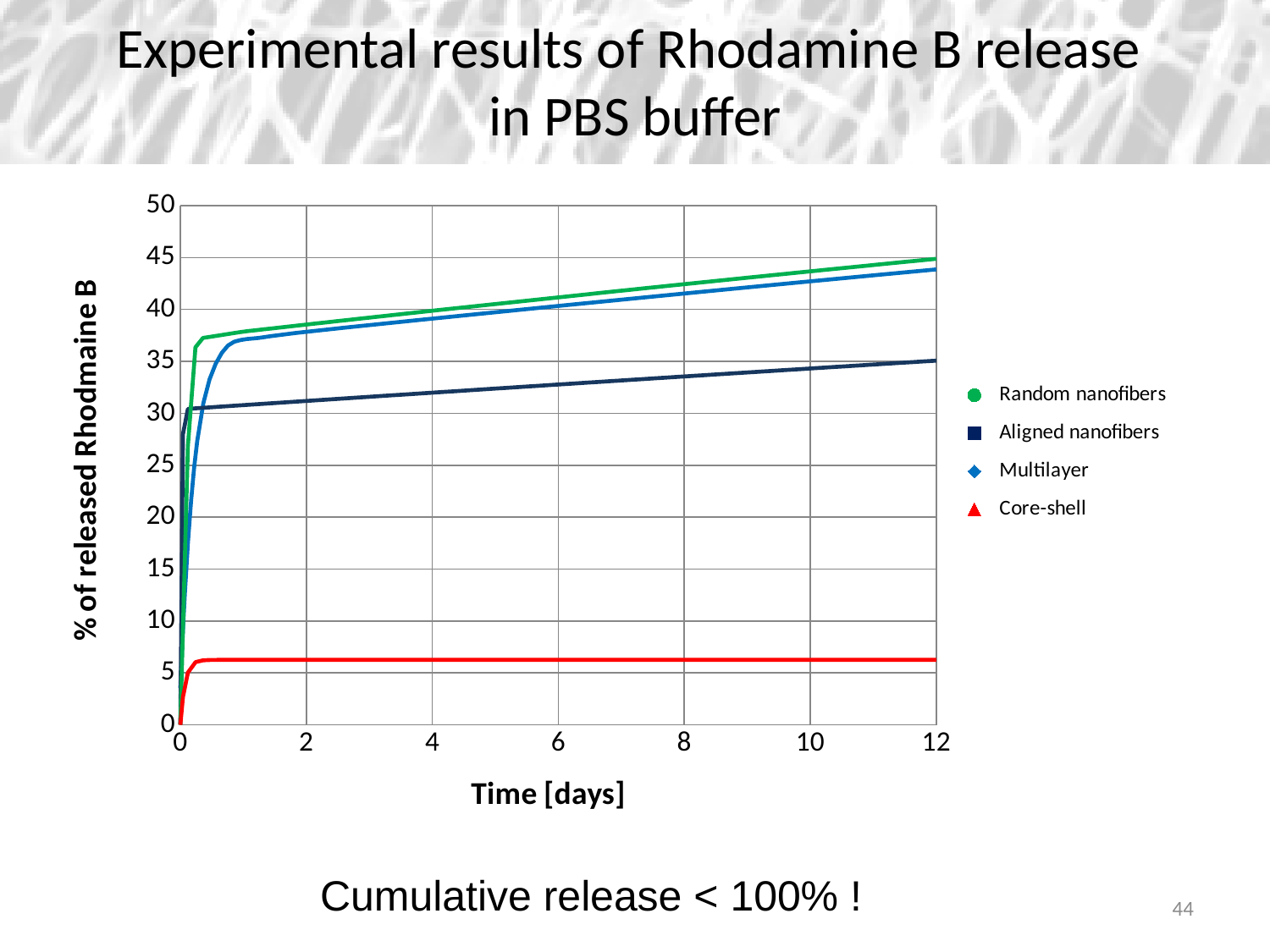
What kind of chart is shown on the slide? line chart How many series does the legend list? 4 Is the value for Random nanofibers at 12 days greater or less than 40? greater At 12 days, which is larger: Aligned nanofibers or Multilayer? Multilayer What is the title of the x axis? Time [days] Does the Aligned nanofibers series rise or fall between 2 and 12 days? rise At 12 days, which is larger: Random nanofibers or Core-shell? Random nanofibers Which series has the lowest value at 12 days? Core-shell Is the value for Multilayer at 12 days greater or less than 40? greater Which series is plotted in red? Core-shell Is the value for Core-shell at 12 days greater or less than 10? less